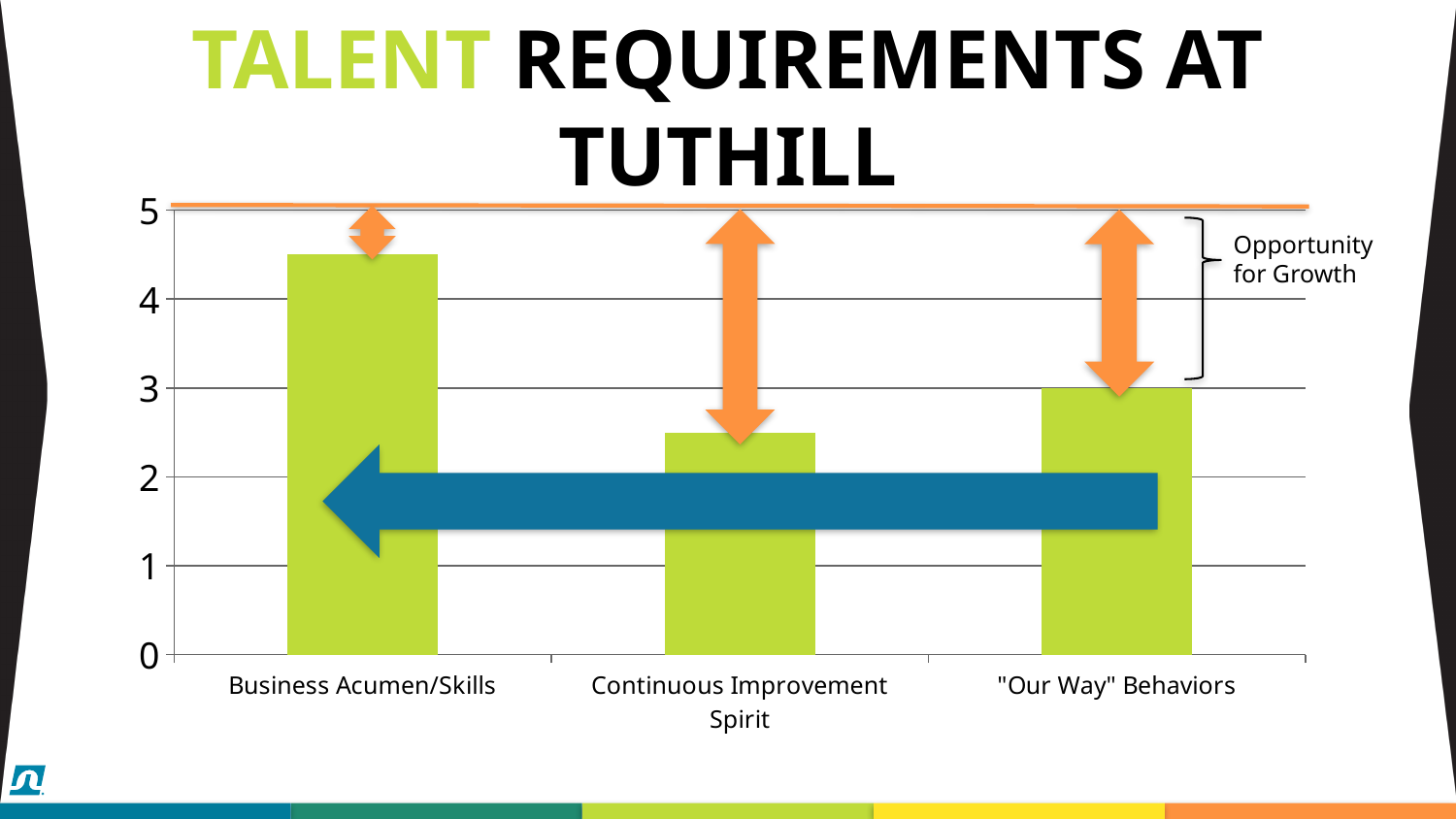
Is the value for Business Acumen/Skills greater or less than 4? greater Which is larger, the value for Continuous Improvement Spirit or the value for "Our Way" Behaviors? "Our Way" Behaviors Is the value for Business Acumen/Skills greater or less than 5? less Which category has the lowest bar? Continuous Improvement Spirit Which category has the highest bar? Business Acumen/Skills Which is larger, the value for Business Acumen/Skills or the value for "Our Way" Behaviors? Business Acumen/Skills Is the value for Continuous Improvement Spirit greater or less than 3? less What label is attached to the bracket next to the orange arrows on the right of the chart? Opportunity for Growth What is the value for "Our Way" Behaviors? 3 How many categories are plotted in the chart? 3 What kind of chart is shown on the slide? bar chart What is the maximum value shown on the vertical axis? 5